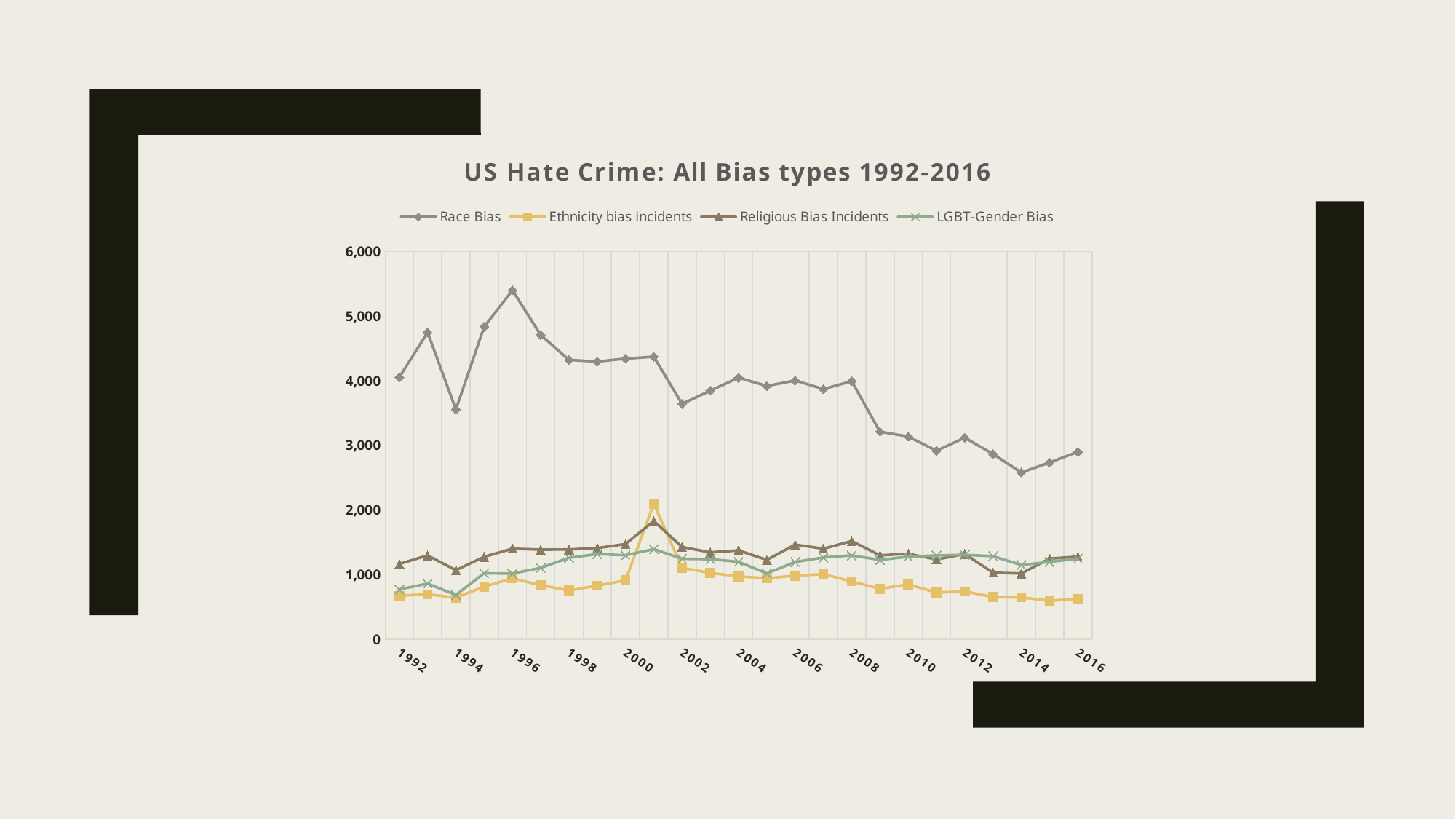
What is the title of the chart? US Hate Crime: All Bias types 1992-2016 In which year does the Race Bias series reach its highest value? 1996 In which year does the Race Bias series reach its lowest value? 2014 Which series has the larger value in 2016, Race Bias or Ethnicity bias incidents? Race Bias What kind of chart is shown on the slide? Line chart Does the Race Bias series generally rise or fall between 2008 and 2014? fall Is the value for Ethnicity bias incidents in 2001 greater or less than 2,000? greater Which series is plotted with a yellow line and square markers? Ethnicity bias incidents Is the value for Race Bias in 2014 greater or less than 3,000? less How many series does the legend list? 4 Is the value for Race Bias in 1996 greater or less than 5,000? greater In which year does the Ethnicity bias incidents series reach its highest value? 2001